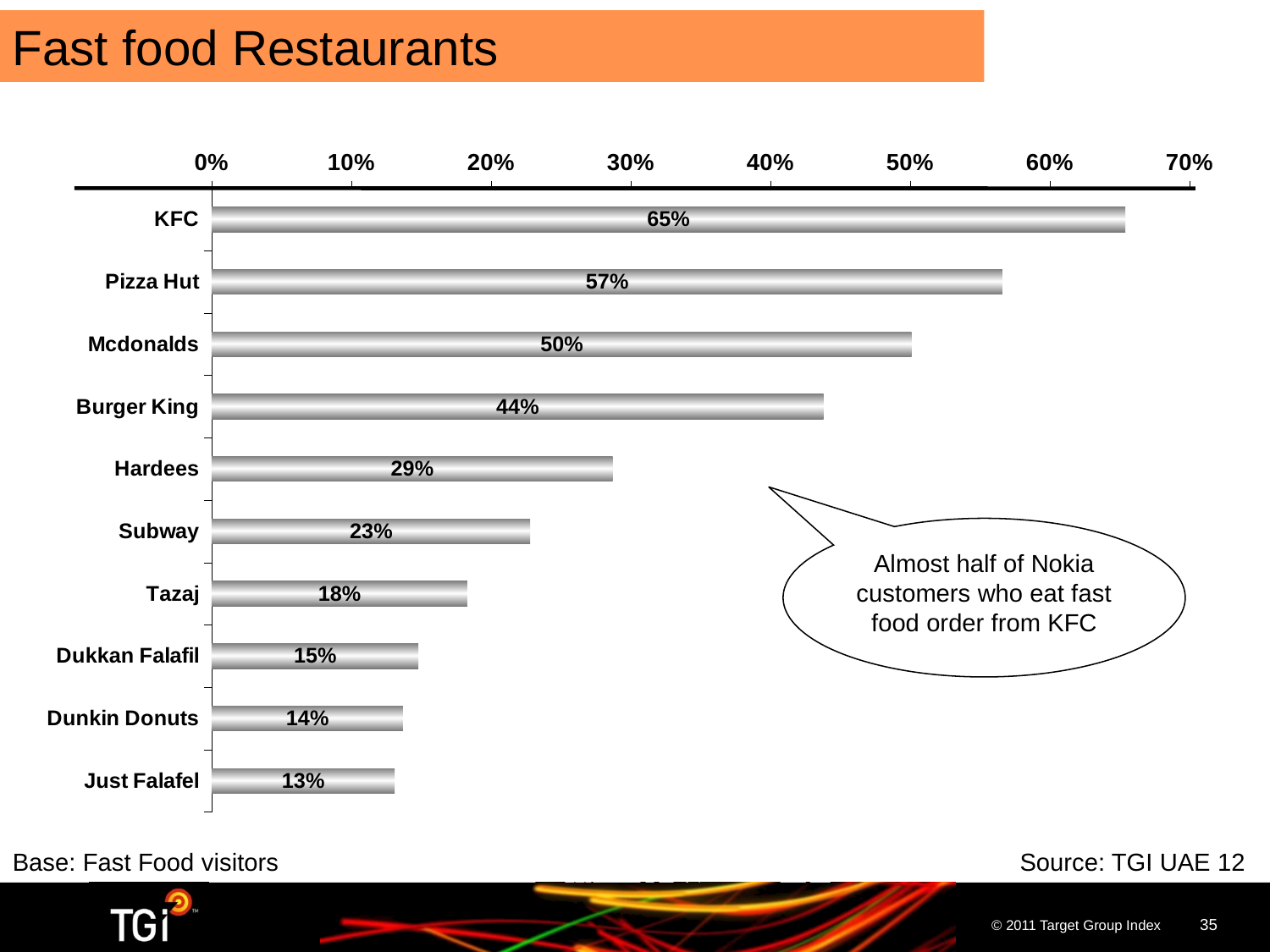
What is the difference between the values for Pizza Hut and Mcdonalds? 7% What is the value for KFC? 65% How many restaurants are shown in the chart? 10 What is the title of the slide? Fast food Restaurants Which restaurant has the lowest value? Just Falafel What is the difference between the values for Burger King and Subway? 21% What kind of chart is shown on the slide? Bar chart Is the value for Burger King greater or less than 40%? greater What is the value for Dunkin Donuts? 14% Which restaurant has the highest value? KFC What is the value for Hardees? 29% Which is larger, the value for Tazaj or the value for Dukkan Falafil? Tazaj